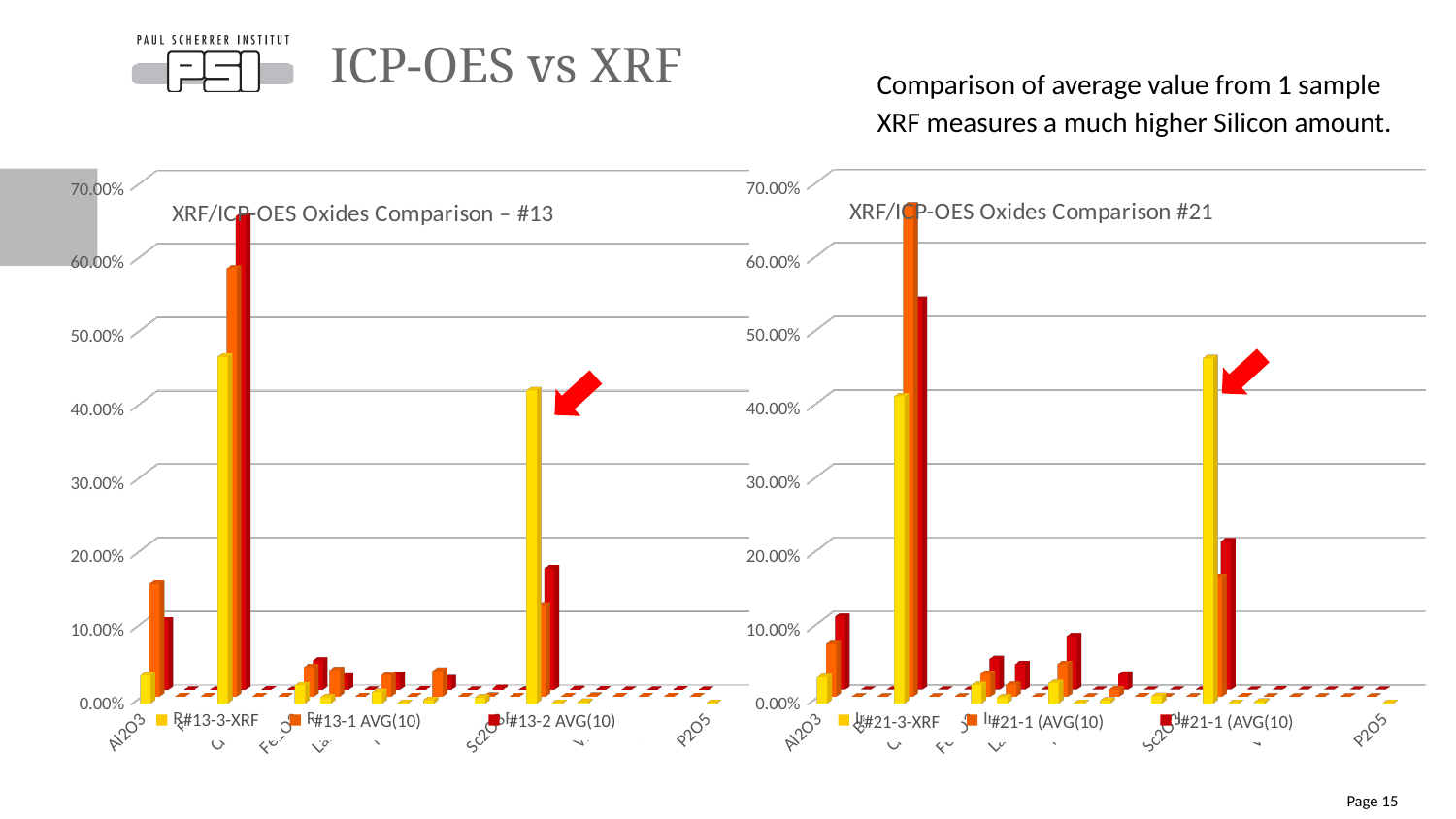
In the left chart, 'XRF/ICP-OES Oxides Comparison – #13', which series contains the tallest bar on the chart? R#13-2 AVG(10) In the left chart, 'XRF/ICP-OES Oxides Comparison – #13', which series has the larger value for Al2O3: R#13-3-XRF or R#13-1 AVG(10)? R#13-1 AVG(10) In the left chart, 'XRF/ICP-OES Oxides Comparison – #13', is the value of the R#13-3-XRF series for Al2O3 greater or less than 10.00%? less In the left chart, 'XRF/ICP-OES Oxides Comparison – #13', is the tallest bar of the R#13-2 AVG(10) series greater or less than 60.00%? greater What is the title of the right chart on the slide? XRF/ICP-OES Oxides Comparison #21 How many series does the legend of the right chart, 'XRF/ICP-OES Oxides Comparison #21', list? 3 In the right chart, 'XRF/ICP-OES Oxides Comparison #21', is the value of the #21-3-XRF series for Al2O3 greater or less than 10.00%? less What kind of chart is the left chart, 'XRF/ICP-OES Oxides Comparison – #13'? bar chart How many series does the legend of the left chart, 'XRF/ICP-OES Oxides Comparison – #13', list? 3 What is the highest value shown on the vertical axis of the left chart, 'XRF/ICP-OES Oxides Comparison – #13'? 70.00%